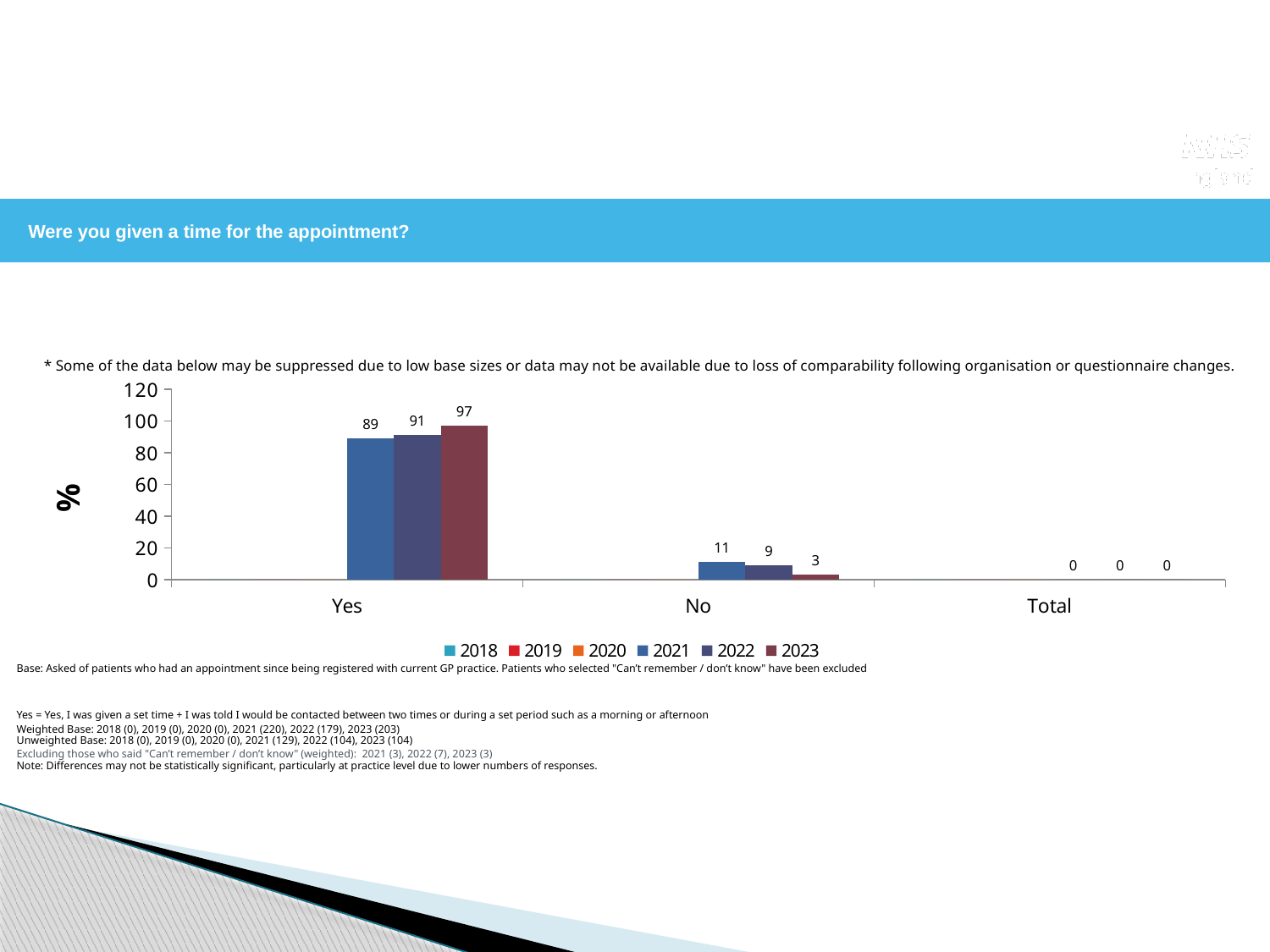
Is the 2021 value for No larger or smaller than the 2022 value for No? larger What is the value for 2021 in the No category? 11 How many categories are shown on the x axis? 3 What is the value for 2022 in the Yes category? 91 What is the value for 2023 in the No category? 3 What is the difference between the 2023 and 2021 values in the Yes category? 8 What is the title of the chart? Were you given a time for the appointment? Which year has the highest value in the Yes category? 2023 What kind of chart is shown on the slide? bar chart How many series does the legend list? 6 What is the value for 2023 in the Yes category? 97